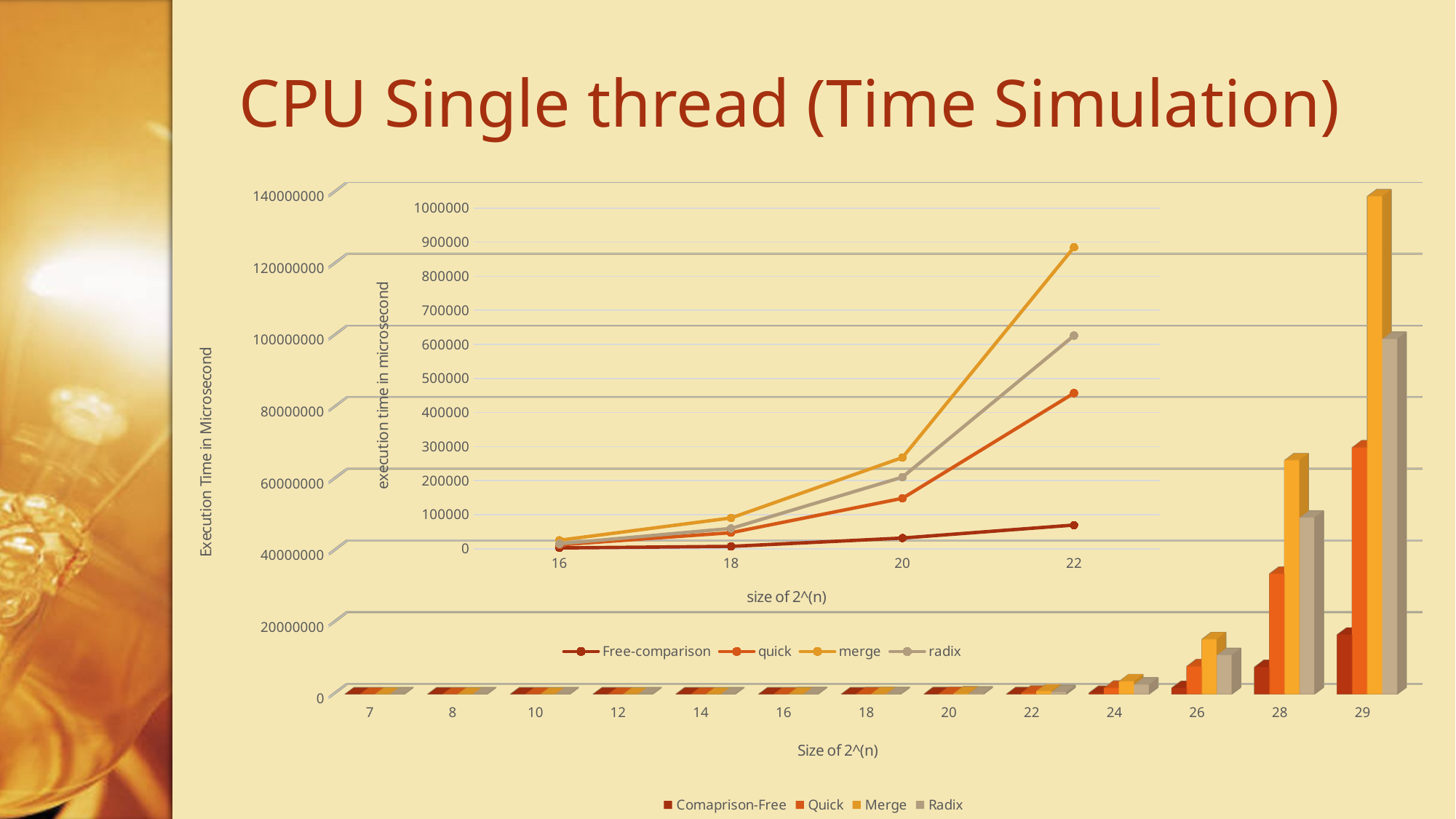
In the large bar chart, which series has the tallest bar at size 29? Merge In the large bar chart, is the Merge value at size 29 greater or less than 120000000? greater In the large bar chart, how many categories are shown on the x-axis? 13 In the large bar chart, at size 28, which is larger: Merge or Quick? Merge What kind of chart is the large chart with the x-axis labelled 'Size of 2^(n)' from 7 to 29? bar chart What kind of chart is the inset chart with the x-axis from 16 to 22? line chart In the inset line chart, is the merge value at size 22 greater or less than 800000? greater In the inset line chart, which series has the highest value at size 22? merge In the inset line chart, how many x-axis categories are shown? 4 In the inset line chart, does the merge series rise or fall from size 16 to size 22? rise In the inset line chart, how many series does the legend list? 4 In the large bar chart, how many series does the legend list? 4